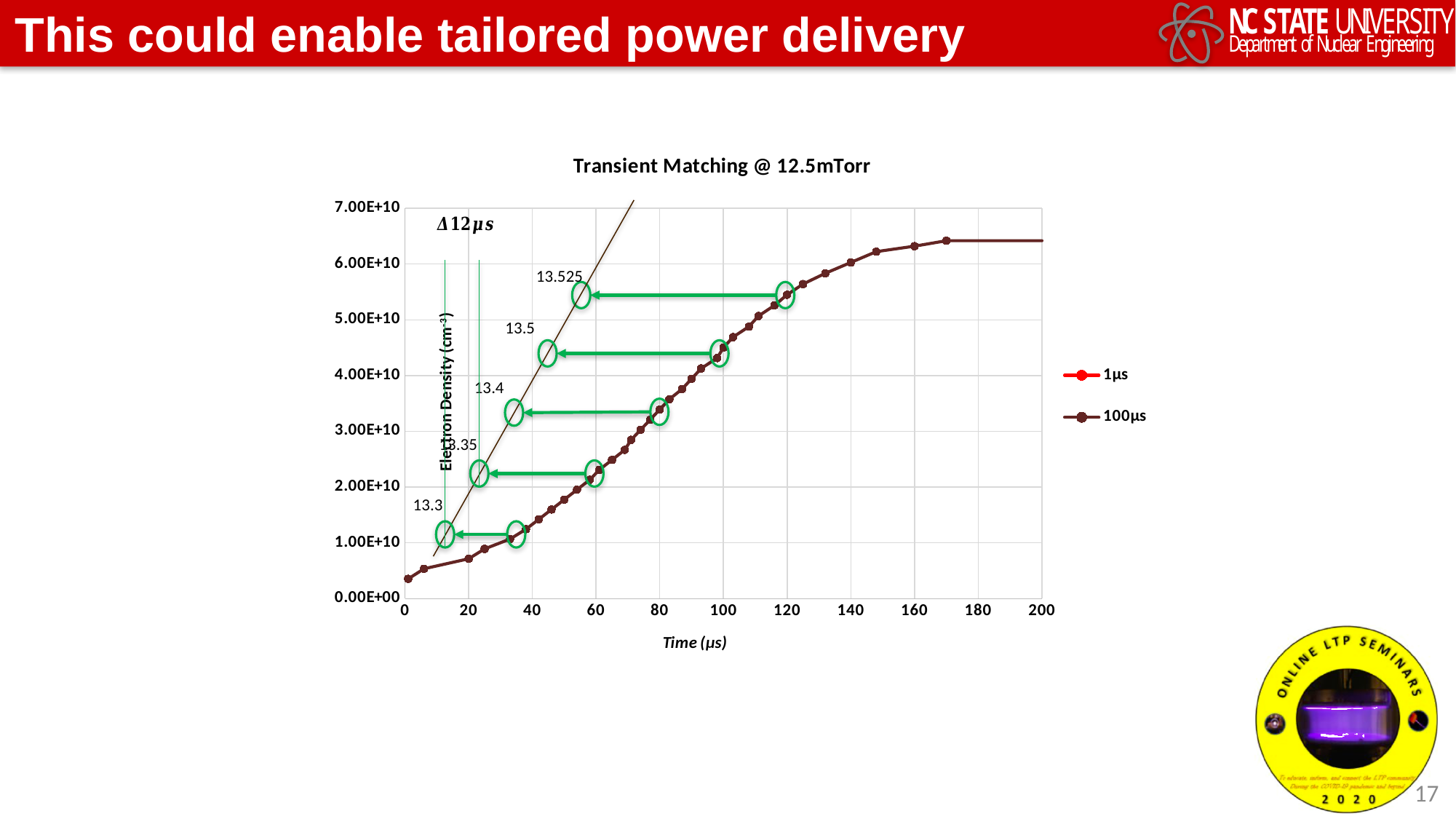
Is the value of the 100μs series at time 100 greater or less than 4.00E+10? greater What is the maximum value shown on the y axis? 7.00E+10 How many series does the chart legend list? 2 Does the 100μs series generally rise or fall as time increases from 0 to 160 μs? rise Is the value of the 100μs series at time 160 greater or less than 6.00E+10? greater Is the value of the 100μs series at time 0 greater or less than 1.00E+10? less What kind of chart is shown on the slide? line chart What is the label of the y axis? Electron Density (cm⁻³) What is the label of the x axis? Time (μs) What is the title of the chart? Transient Matching @ 12.5mTorr What is the maximum value shown on the x axis? 200 What are the two series named in the legend? 1μs and 100μs